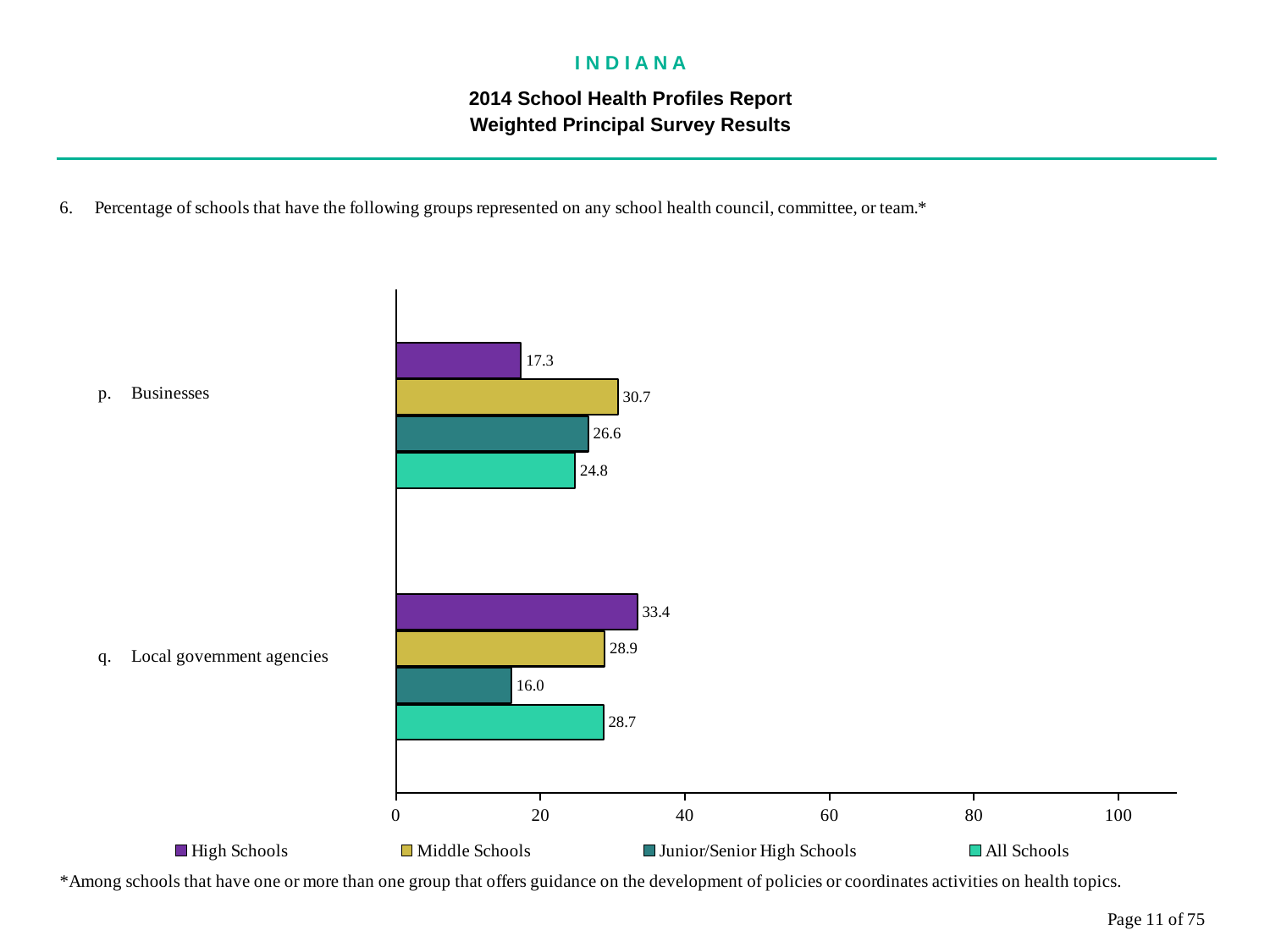
Which is larger: the High Schools value for Businesses or the High Schools value for Local government agencies? Local government agencies What is the value for All Schools in the Businesses category? 24.8 What is the value for High Schools in the Businesses category? 17.3 What kind of chart is shown on the slide? bar chart Which series has the highest value in the Businesses category? Middle Schools How many series does the legend list? 4 Which legend entry is shown in purple? High Schools Is the value for Middle Schools in the Local government agencies category greater or less than 40? less How many categories are shown on the chart? 2 What is the value for Junior/Senior High Schools in the Local government agencies category? 16.0 Which series has the lowest value in the Local government agencies category? Junior/Senior High Schools What is the difference between the Middle Schools and High Schools values in the Businesses category? 13.4